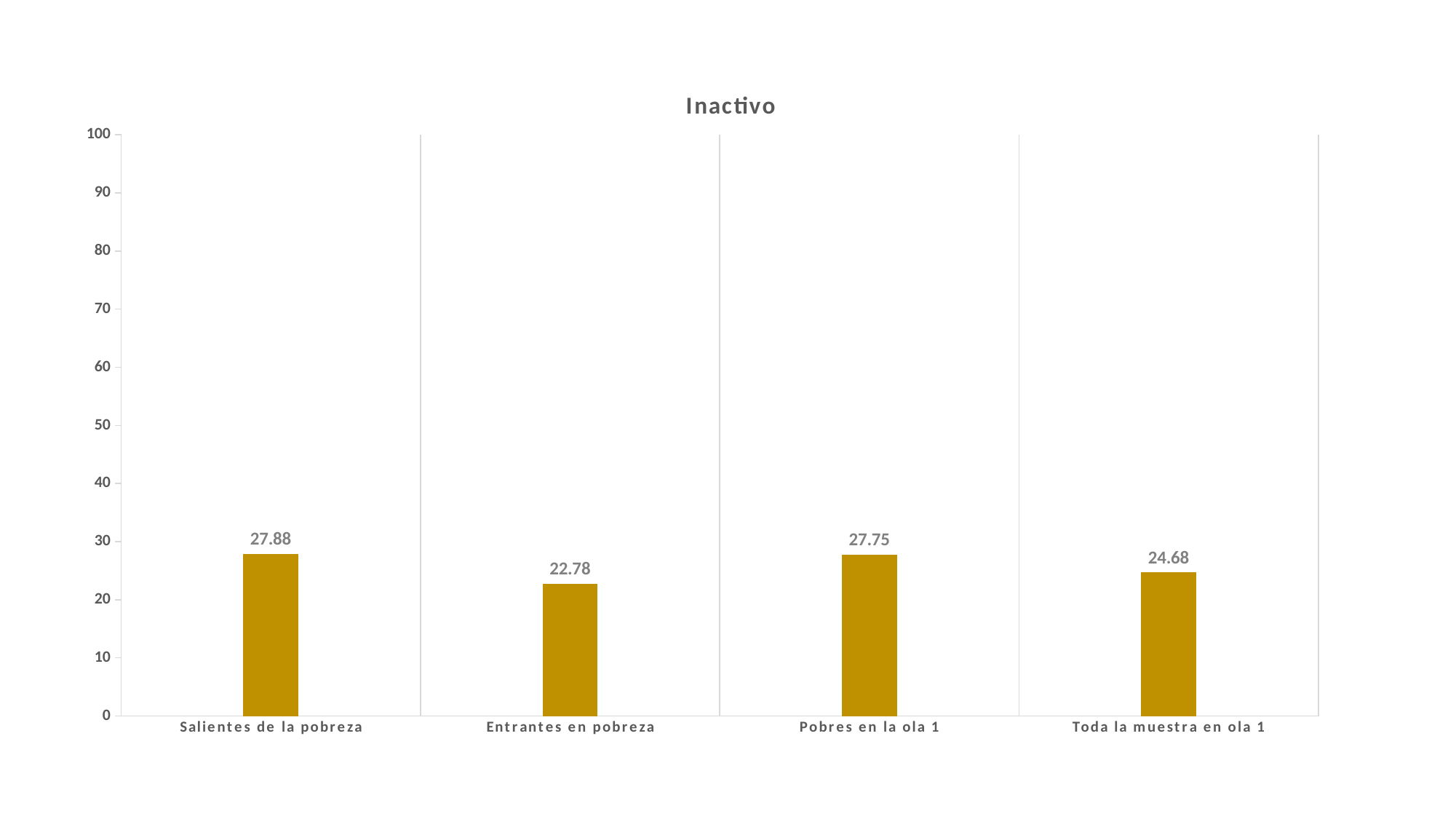
How many categories are shown on the chart? 4 What is the value for Salientes de la pobreza? 27.88 What is the difference between the values for Pobres en la ola 1 and Toda la muestra en ola 1? 3.07 What is the value for Pobres en la ola 1? 27.75 Which category has the lowest value? Entrantes en pobreza Which category has the highest value? Salientes de la pobreza What is the value for Toda la muestra en ola 1? 24.68 Which is larger, the value for Toda la muestra en ola 1 or the value for Entrantes en pobreza? Toda la muestra en ola 1 What is the value for Entrantes en pobreza? 22.78 Is the value for Pobres en la ola 1 greater or less than 30? less What is the title of the chart? Inactivo What is the difference between the values for Salientes de la pobreza and Entrantes en pobreza? 5.10